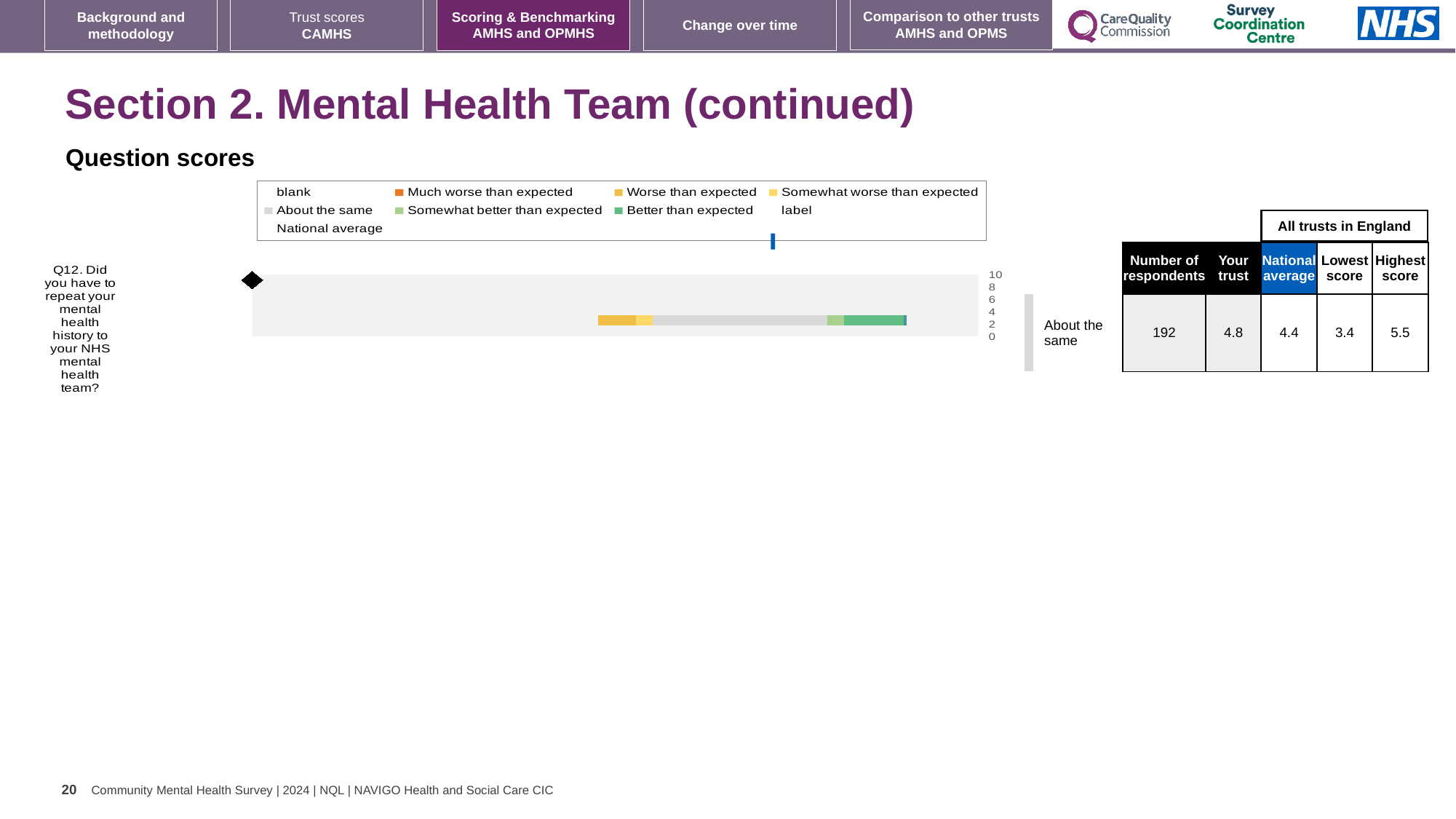
How many survey questions are plotted on the chart? 1 Which is larger for Q12, the 'Your trust' score or the national average? Your trust What kind of chart is used to show the Q12 question score? bar chart What is the national average score for Q12? 4.4 What is the 'Your trust' score for Q12? 4.8 What is the highest score among all trusts in England for Q12? 5.5 What is the lowest score among all trusts in England for Q12? 3.4 What is the difference between the highest score and the lowest score for Q12? 2.1 What is the difference between the 'Your trust' score and the national average for Q12? 0.4 Which survey question is plotted on the chart? Q12. Did you have to repeat your mental health history to your NHS mental health team? What benchmark category is shown next to the chart for Q12? About the same How many respondents answered Q12? 192